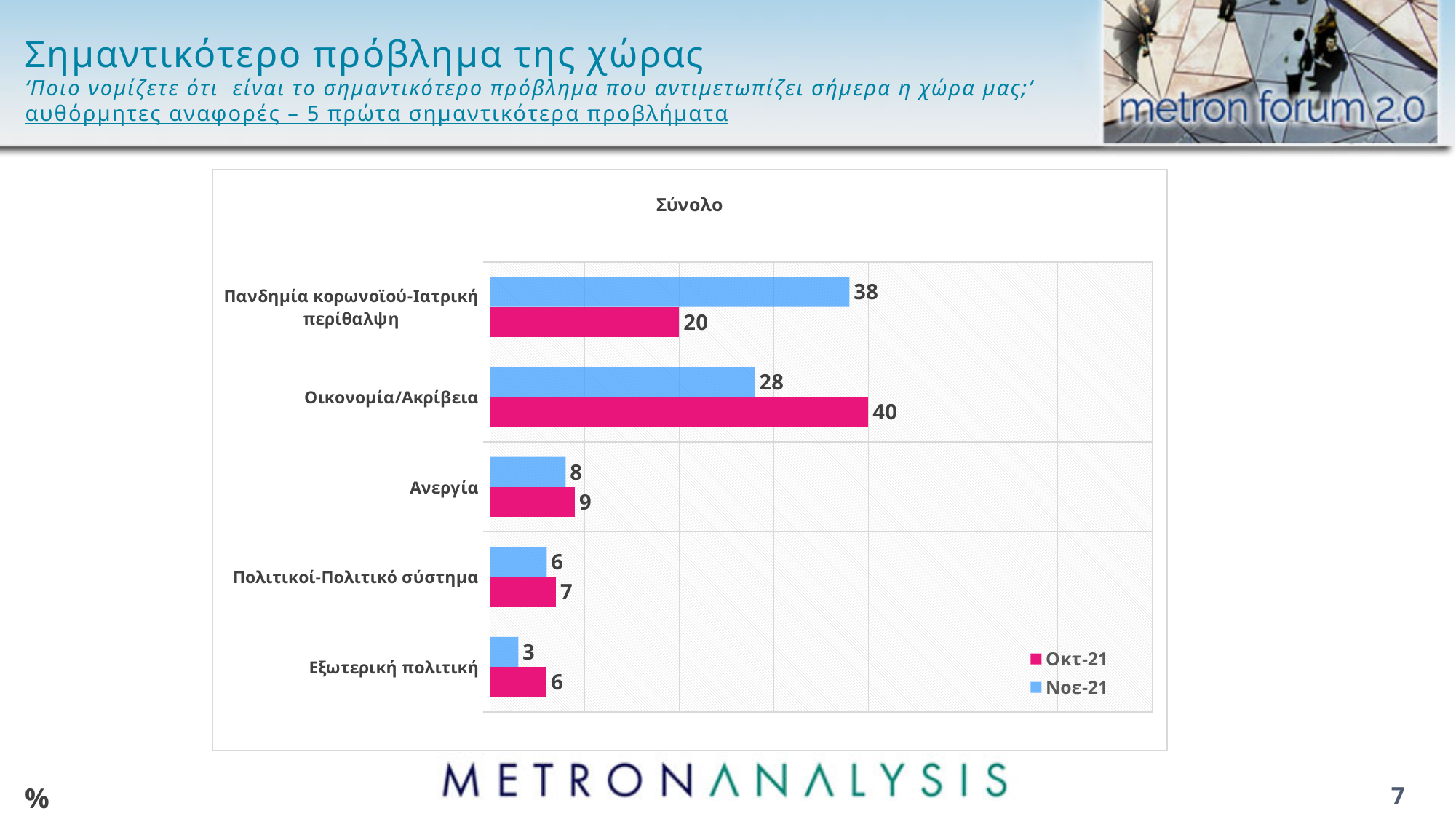
What kind of chart is shown on the slide? Bar chart Which category has the lowest value in the Οκτ-21 series? Εξωτερική πολιτική What is the difference between the Νοε-21 and Οκτ-21 values for Πανδημία κορωνοϊού-Ιατρική περίθαλψη? 18 How many categories are shown in the chart? 5 How many series does the legend list? 2 What is the value for Εξωτερική πολιτική in the Νοε-21 series? 3 Which is larger for Πολιτικοί-Πολιτικό σύστημα: the Οκτ-21 value or the Νοε-21 value? Οκτ-21 What is the value for Πανδημία κορωνοϊού-Ιατρική περίθαλψη in the Νοε-21 series? 38 What is the value for Οικονομία/Ακρίβεια in the Οκτ-21 series? 40 What is the value for Ανεργία in the Οκτ-21 series? 9 Which category has the highest value in the Νοε-21 series? Πανδημία κορωνοϊού-Ιατρική περίθαλψη What is the difference between the Οκτ-21 and Νοε-21 values for Οικονομία/Ακρίβεια? 12